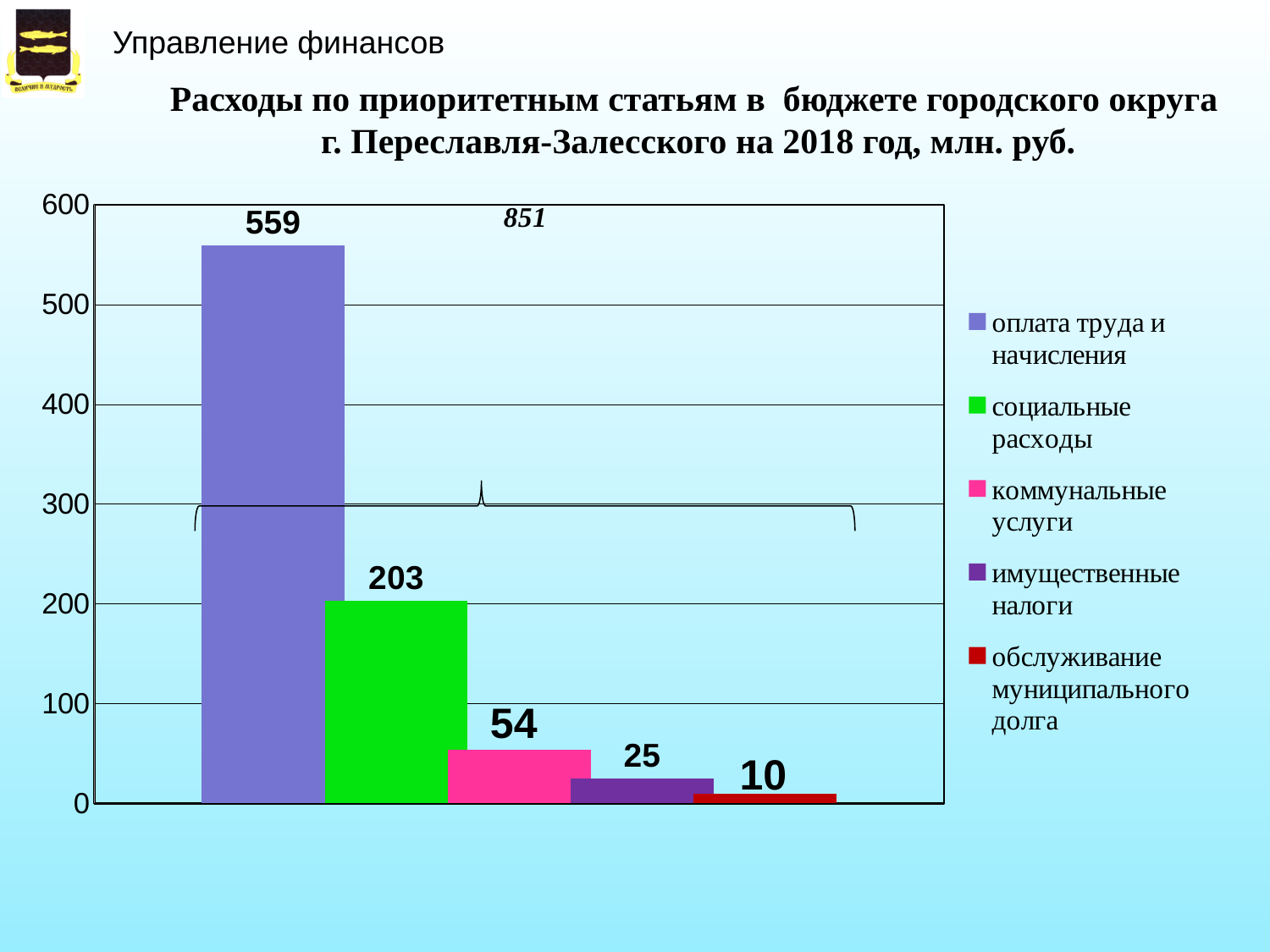
Is the value for социальные расходы greater or less than 300? less What is the value for обслуживание муниципального долга? 10 Which category has the lowest value? обслуживание муниципального долга What is the value for оплата труда и начисления? 559 What is the value for социальные расходы? 203 Which is larger, коммунальные услуги or имущественные налоги? коммунальные услуги What kind of chart is shown on the slide? bar chart What is the value for коммунальные услуги? 54 What total is printed above the bars on the chart? 851 What is the difference between оплата труда и начисления and социальные расходы? 356 How many series does the legend list? 5 Which category has the highest value? оплата труда и начисления